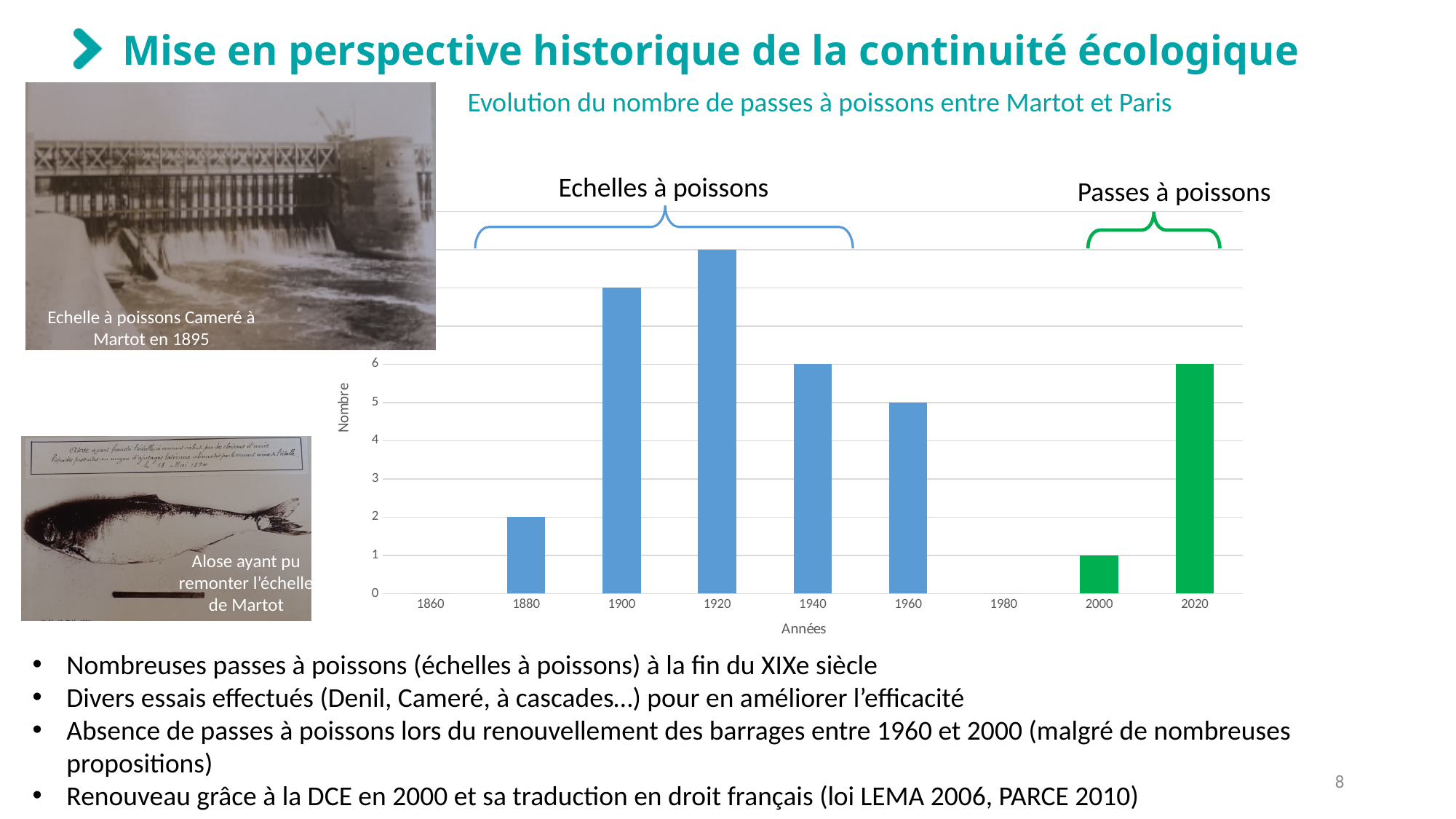
What is the value for 1880? 2 Is the value for 1900 greater or less than 6? greater What is the value for 1960? 5 What is the value for 2000? 1 What is the value for 1940? 6 What is the value for 2020? 6 What is the title of the chart? Evolution du nombre de passes à poissons entre Martot et Paris Which year has the highest bar? 1920 Which is larger, the value for 1940 or the value for 1960? 1940 How many years are labelled on the x axis? 9 What is the difference between the values for 2020 and 2000? 5 What type of chart is shown on the slide? bar chart